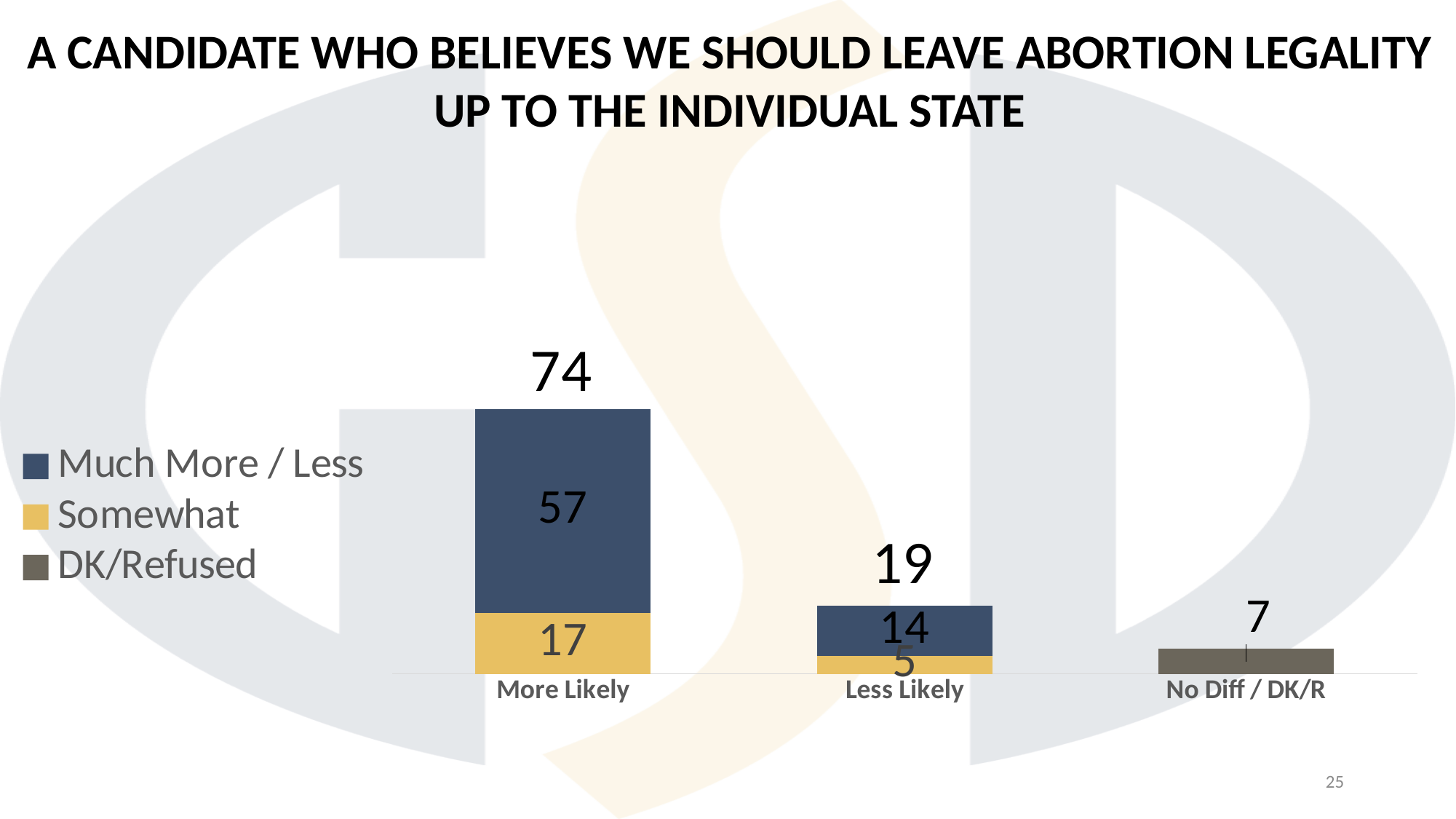
How many series does the legend list? 3 What is the total shown above the More Likely bar? 74 What is the value of the Much More / Less series for More Likely? 57 What kind of chart is shown on the slide? Stacked bar chart What is the total shown above the Less Likely bar? 19 Which is larger: the Somewhat value for More Likely or the Somewhat value for Less Likely? More Likely What is the value of the Somewhat series for Less Likely? 5 Which category has the highest total? More Likely What is the value of the DK/Refused series for No Diff / DK/R? 7 How many categories are shown on the x axis? 3 Which category has the lowest total? No Diff / DK/R What is the difference between the Much More / Less values for More Likely and Less Likely? 43